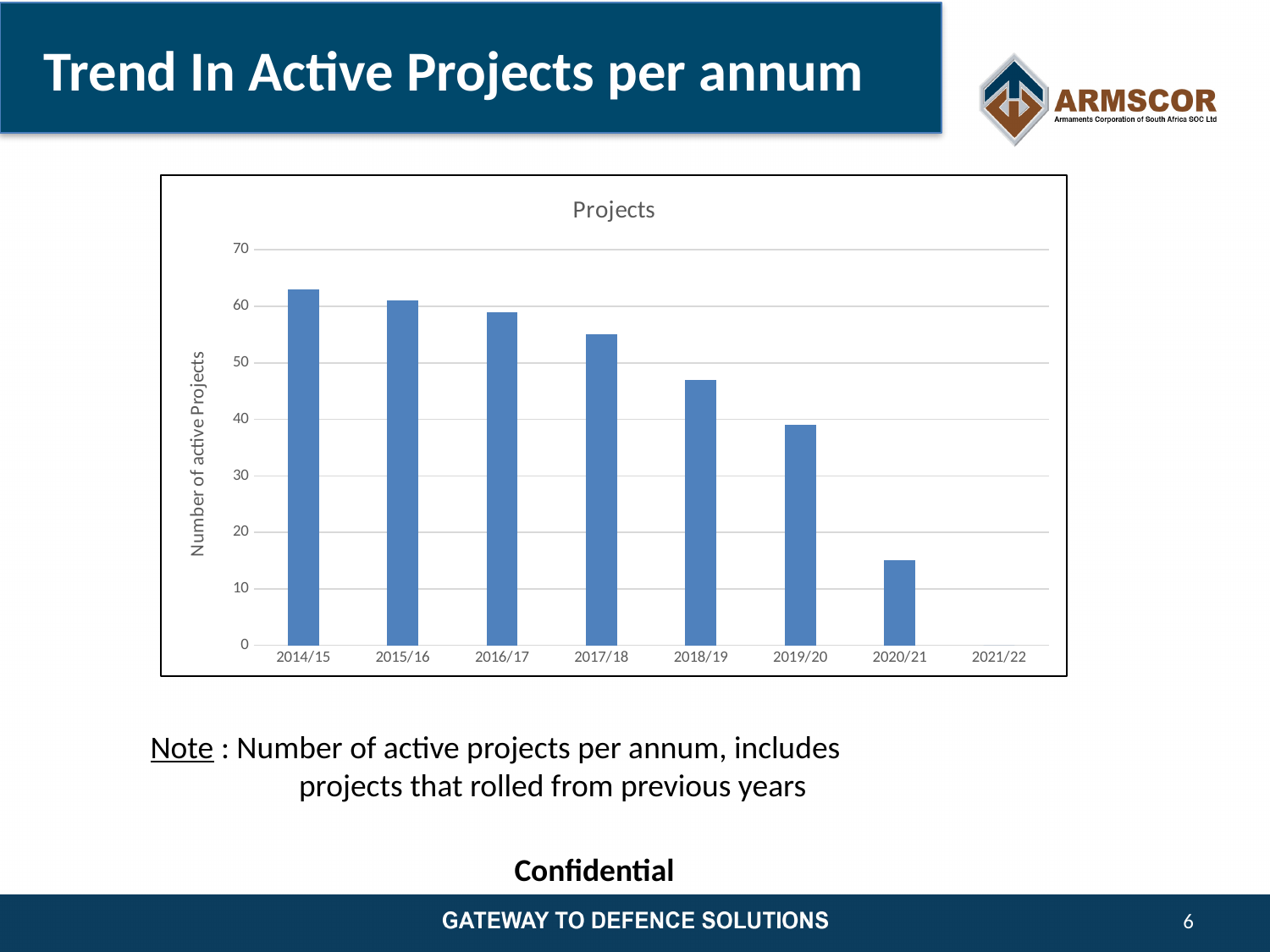
Is the value for 2020/21 greater or less than 20? less What type of chart is shown on the slide? Bar chart Which is larger, the value for 2014/15 or the value for 2019/20? 2014/15 How many year categories are shown on the x axis of the chart? 8 What is the label on the vertical axis of the chart? Number of active Projects Is the value for 2018/19 greater or less than 50? less Which year has the shortest visible bar in the chart? 2020/21 Do the values rise or fall from 2014/15 to 2020/21? fall Which year on the x axis has no bar plotted? 2021/22 Which year has the tallest bar in the chart? 2014/15 What is the title of the chart? Projects Is the value for 2014/15 greater or less than 60? greater